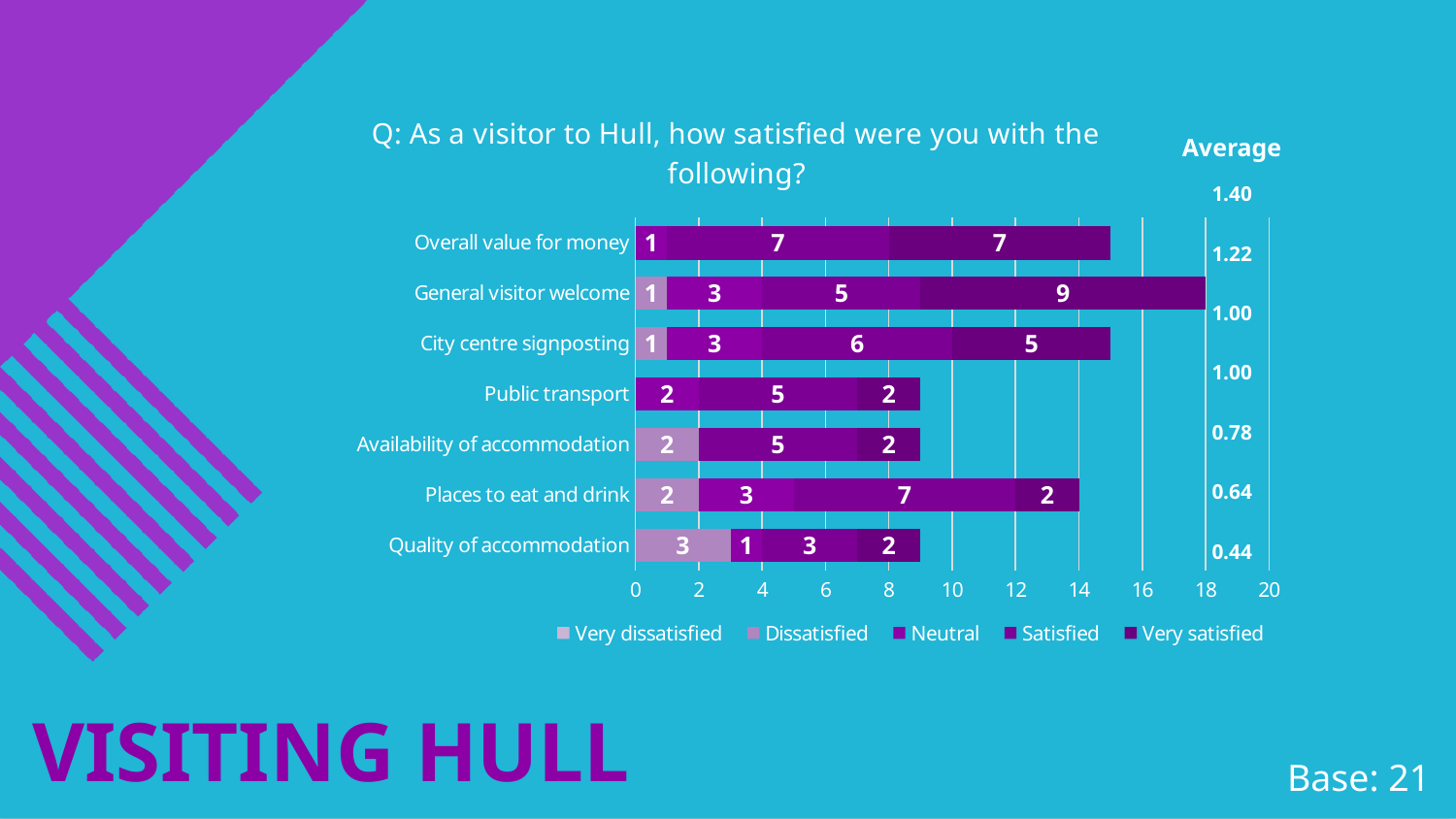
How many categories are plotted on the chart? 7 What is the difference between the total bar for General visitor welcome and the total bar for Overall value for money? 3 Is the total bar length for Quality of accommodation greater or less than 10? less Which has the larger total bar: Places to eat and drink or Public transport? Places to eat and drink What is the total of the stacked bar for General visitor welcome? 18 What kind of chart is shown on the slide? Stacked bar chart What is the largest single segment value shown in the General visitor welcome bar? 9 What is the total of the stacked bar for Public transport? 9 What is the total of the stacked bar for Overall value for money? 15 How many series does the legend list? 5 What is the highest value listed in the Average column to the right of the chart? 1.40 Which category has the longest stacked bar overall? General visitor welcome